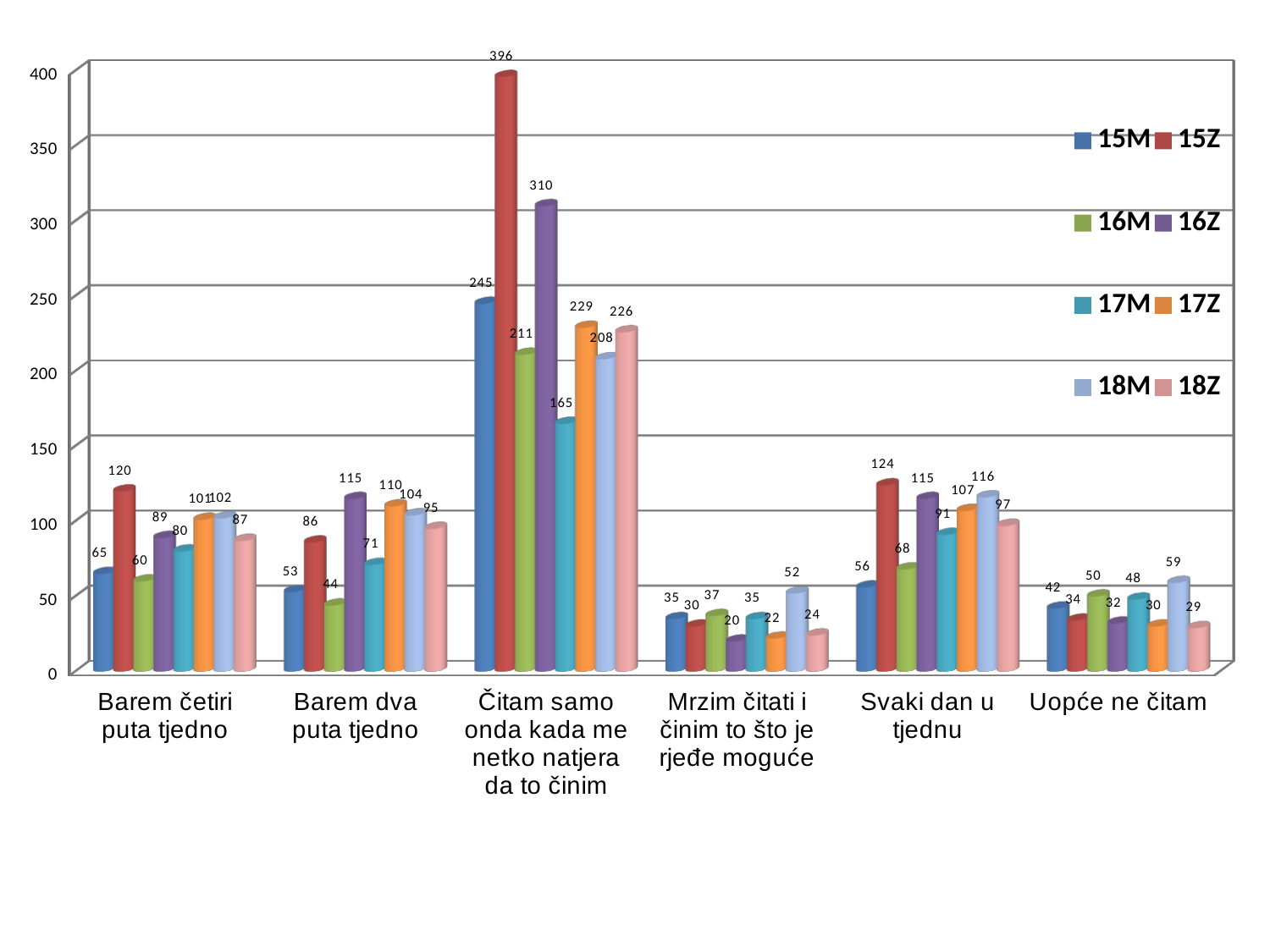
What is the value for 15Z in the category "Čitam samo onda kada me netko natjera da to činim"? 396 What is the difference between the 15Z and 15M values in the category "Čitam samo onda kada me netko natjera da to činim"? 151 What kind of chart is shown on the slide? Bar chart How many categories are shown on the x axis? 6 How many series does the legend list? 8 What is the difference between the 18M and 18Z values in the category "Uopće ne čitam"? 30 What is the value for 18M in the category "Mrzim čitati i činim to što je rjeđe moguće"? 52 Which series has the lowest value in the category "Barem četiri puta tjedno"? 16M What is the value for 16M in the category "Uopće ne čitam"? 50 Which series has the highest value in the category "Barem dva puta tjedno"? 16Z What is the value for 17Z in the category "Svaki dan u tjednu"? 107 In the category "Svaki dan u tjednu", which is larger: the value for 15Z or the value for 18M? 15Z